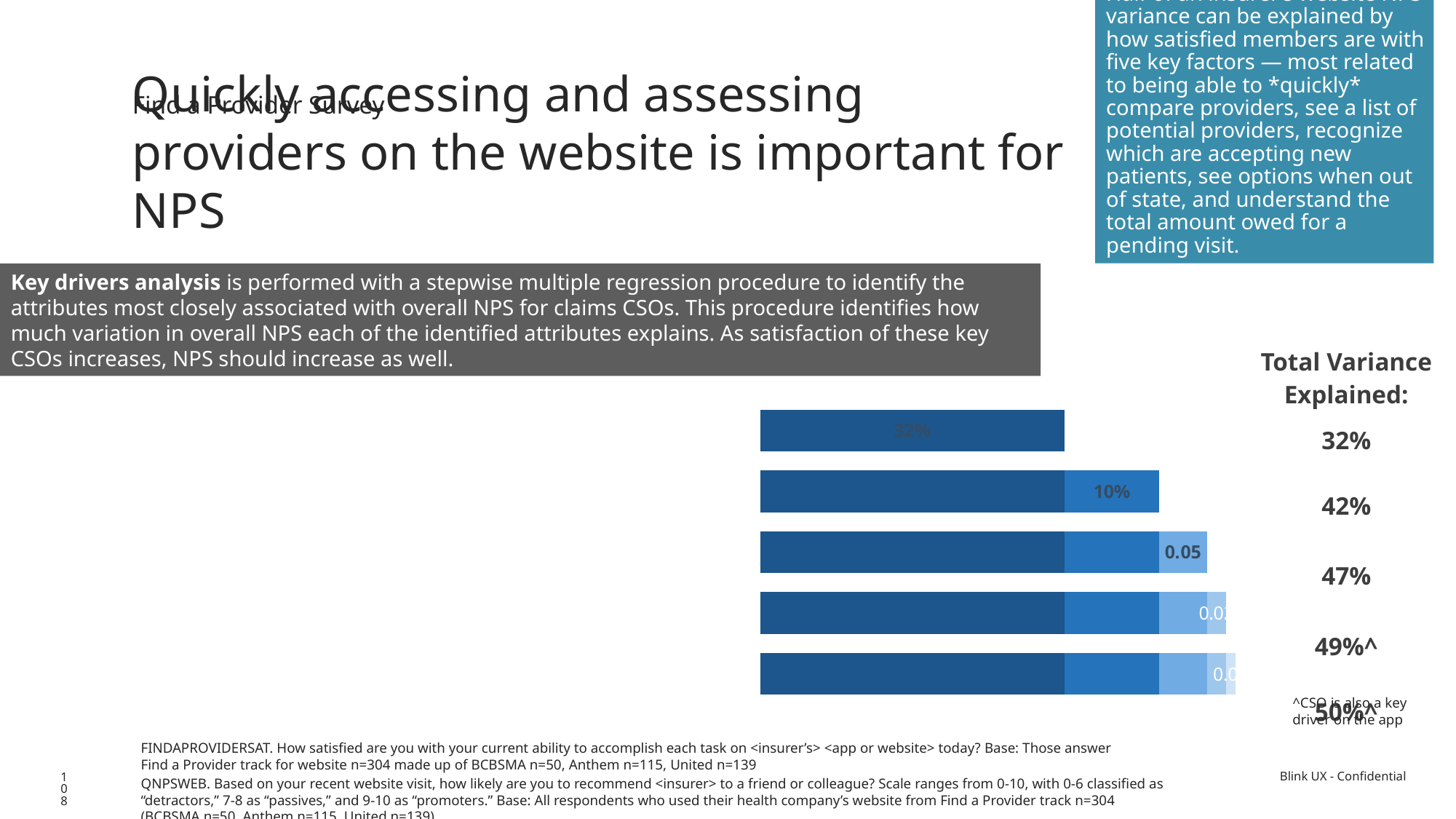
What kind of chart is shown on the slide? bar chart Which bar in the chart is the shortest? the top bar By how much does the Total Variance Explained increase from the first bar (32%) to the second bar (42%)? 10% Which bar in the chart is the longest? the bottom bar What data label is printed on the top bar of the chart? 32% Do the bars get longer or shorter going from the top of the chart to the bottom? longer What does the footnote marked with a caret (^) next to the Total Variance Explained values say? ^CSO is also a key driver on the app What is the Total Variance Explained value listed next to the third bar? 47% What data label is printed on the second (lighter blue) segment of the second bar from the top? 10% What is the final Total Variance Explained value listed next to the bottom bar? 50%^ How many bars does the chart contain? 5 What data label is printed on the third segment of the third bar from the top? 0.05